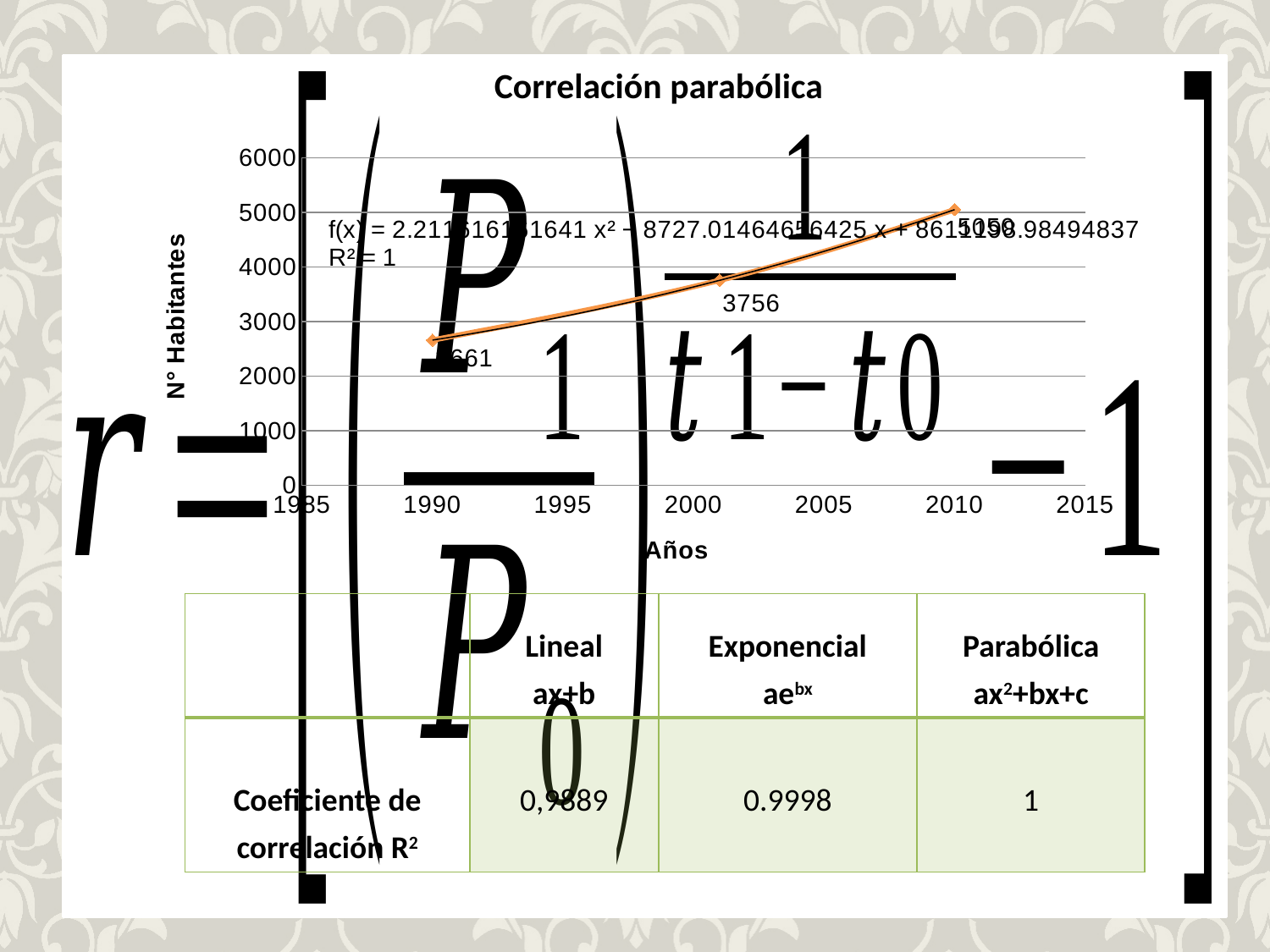
Is the value for 2010 greater or less than 4000? greater What is the label of the vertical axis of the chart? N° Habitantes Is the value for 1990 greater or less than 3000? less How many data points are plotted on the chart? 3 What R² value is shown on the chart? R² = 1 What is the title of the chart? Correlación parabólica Do the values rise or fall as the years increase along the x axis? rise Which year has the lowest value on the chart? 1990 What kind of chart is shown on the slide? line chart Which year has the highest value on the chart? 2010